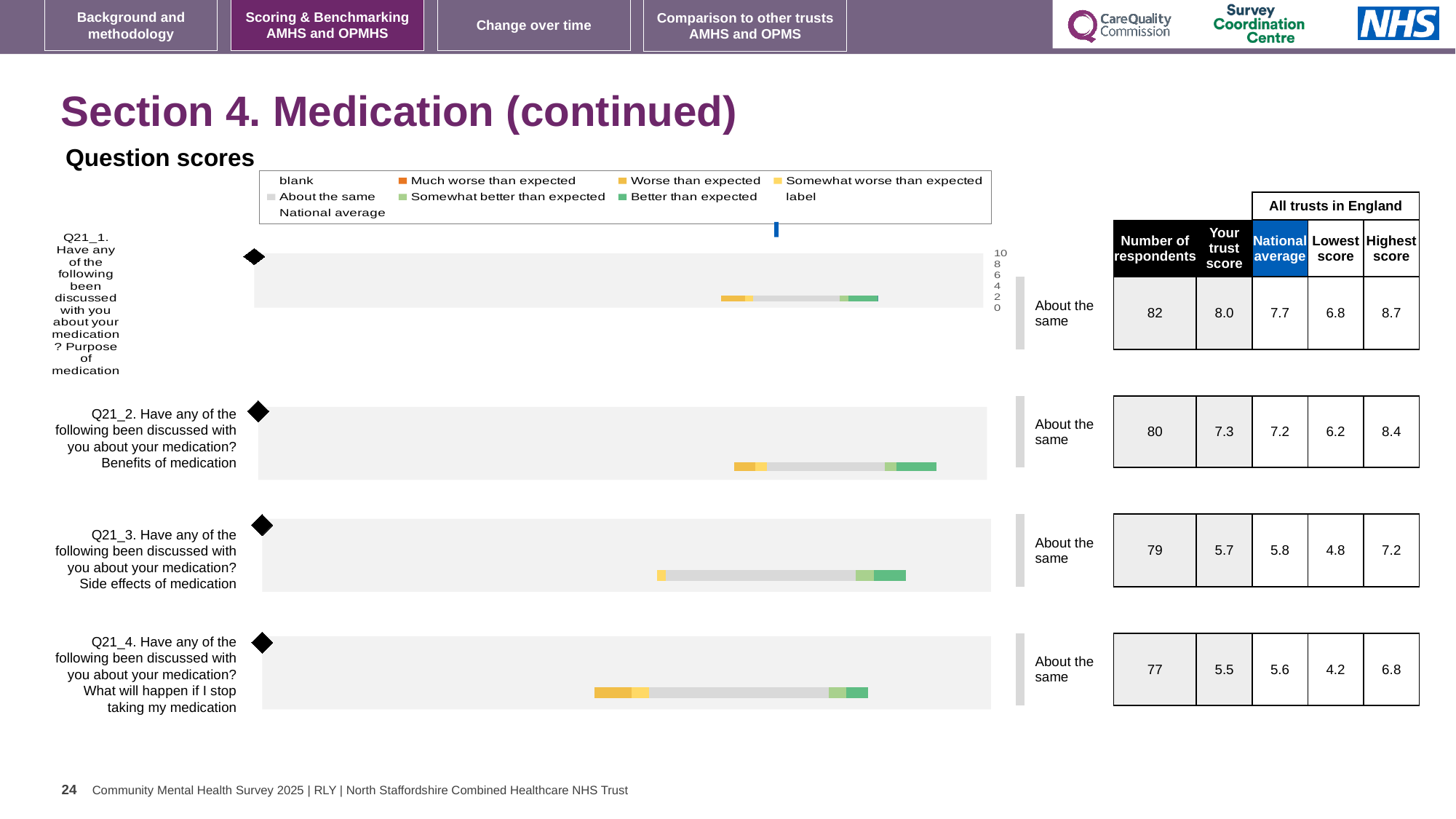
What benchmark category is shown for Q21_2? About the same For Q21_3, which is larger: the trust score or the national average? National average Which question has the highest trust score? Q21_1 (Purpose of medication) What is the national average for Q21_2 (Benefits of medication)? 7.2 What is the lowest score among all trusts in England for Q21_4 (What will happen if I stop taking my medication)? 4.2 How many questions (Q21_1 to Q21_4) are plotted on the slide? 4 Which question has the lowest trust score? Q21_4 (What will happen if I stop taking my medication) What is the difference between the trust score and the national average for Q21_1? 0.3 What kind of chart is used to show the question scores on this slide? bar chart How many respondents answered Q21_3 (Side effects of medication)? 79 What is the trust's score for Q21_1 (Purpose of medication)? 8.0 What is the maximum value shown on the score axis of the charts? 10